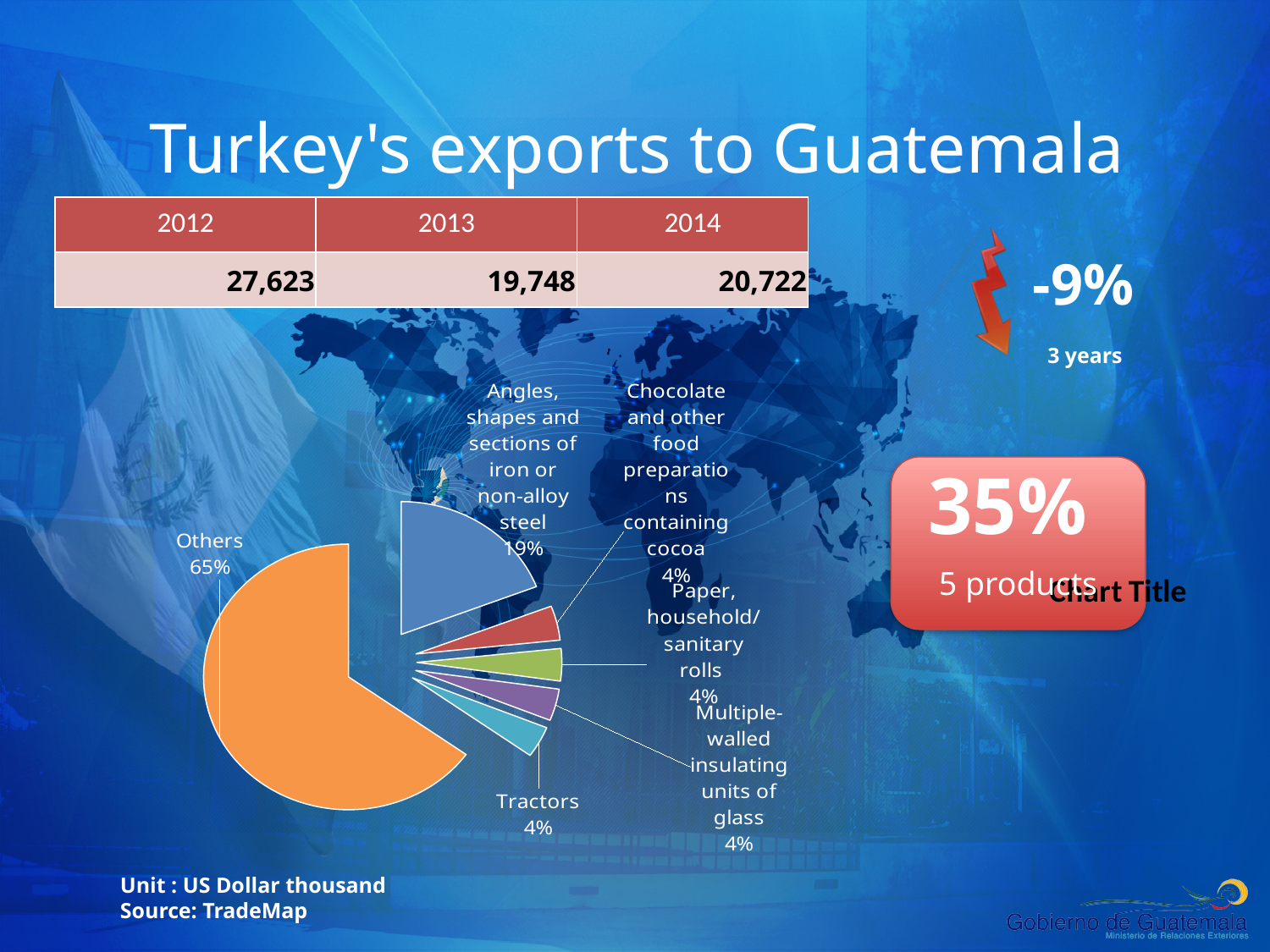
What percentage is shown for "Tractors" in the pie chart? 4% What kind of chart is shown on the slide? pie chart What colour is the "Others" slice in the pie chart? orange How many slices does the pie chart have? 6 Which slice of the pie chart is the largest? Others Which is larger in the pie chart: "Others" or "Angles, shapes and sections of iron or non-alloy steel"? Others What percentage is shown for "Multiple-walled insulating units of glass"? 4% What share of the pie does the "Others" slice represent? 65% What percentage is shown for "Chocolate and other food preparations containing cocoa"? 4% What is the difference in percentage points between the "Angles, shapes and sections of iron or non-alloy steel" slice and the "Paper, household/sanitary rolls" slice? 15 What is the difference in percentage points between the "Others" slice and the "Angles, shapes and sections of iron or non-alloy steel" slice? 46 What percentage is shown for "Angles, shapes and sections of iron or non-alloy steel"? 19%